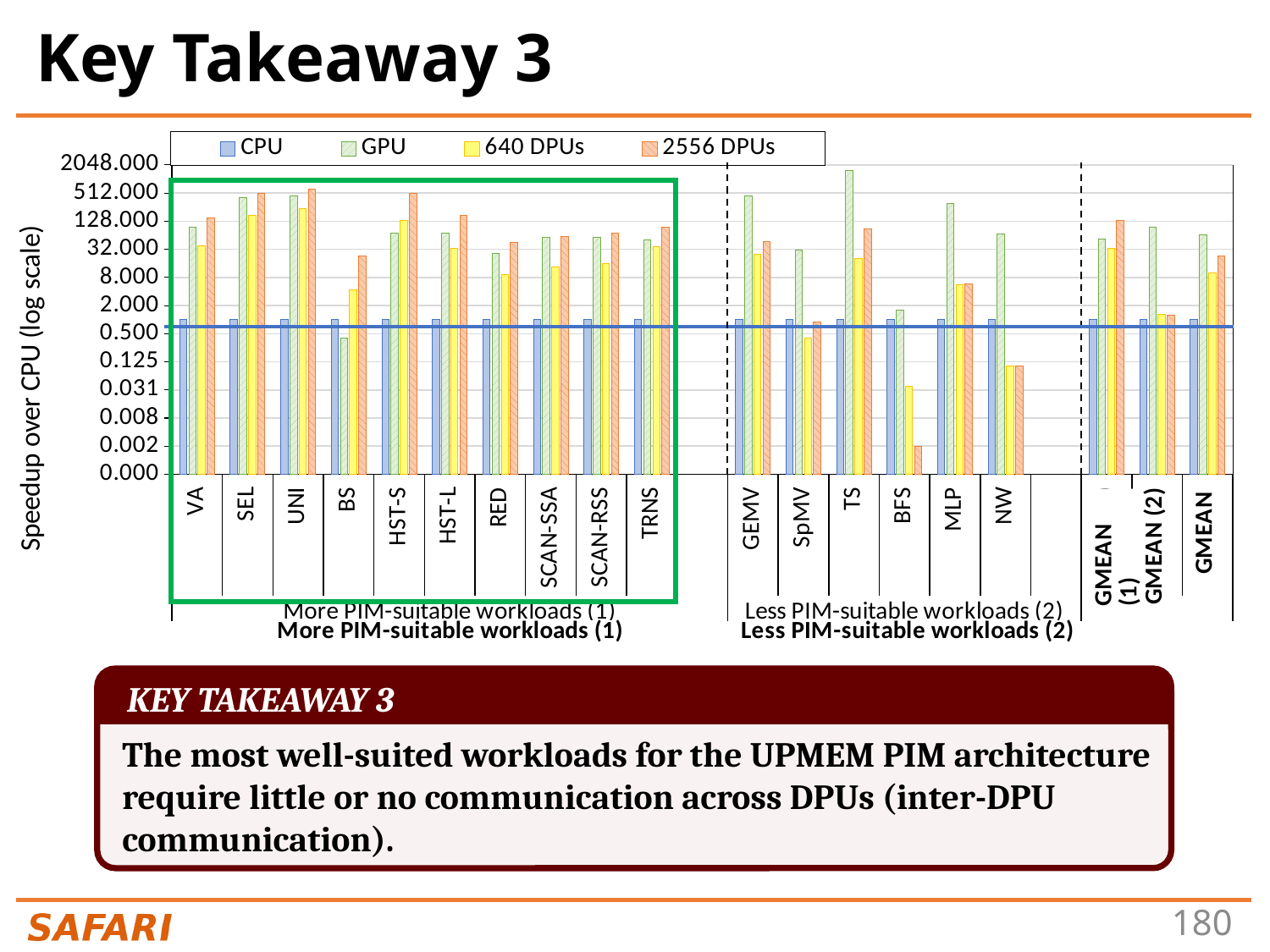
For BS, which is larger: the GPU value or the 640 DPUs value? 640 DPUs Is the GPU value for TS greater or less than 512? greater Is the GPU value for GEMV greater or less than 128? greater Is the 640 DPUs value for NW greater or less than 0.5? less What kind of chart is shown on the slide? bar chart Which workload has the highest GPU bar? TS Which series has the highest bar for TS? GPU How many series does the legend list? 4 What is the label of the y axis? Speedup over CPU (log scale) For NW, which is larger: the GPU value or the 2556 DPUs value? GPU